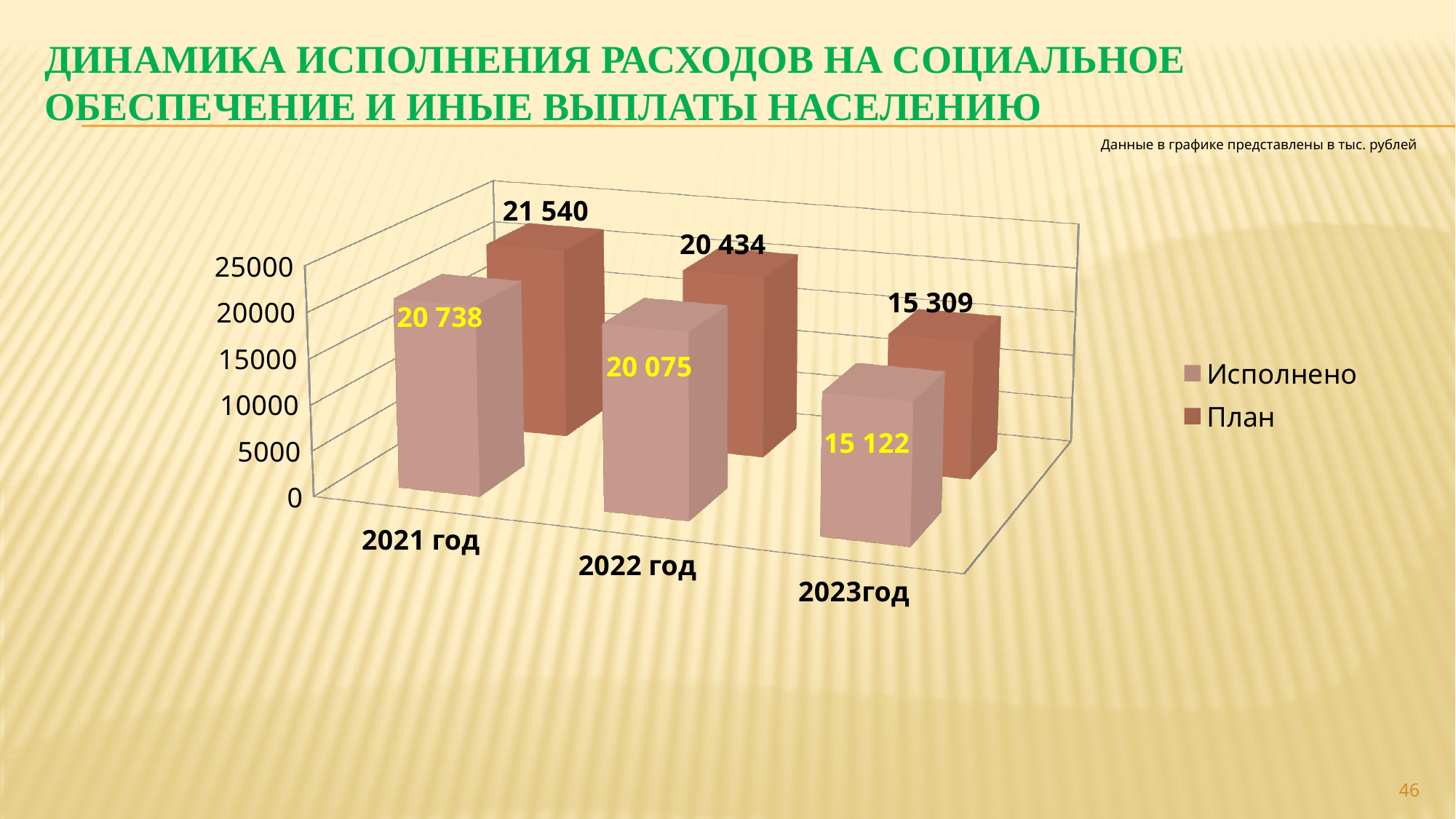
What is the difference between План and Исполнено for 2021 год? 802 What is the difference between План and Исполнено for 2022 год? 359 What is the value of План for 2022 год? 20 434 Which year has the lowest Исполнено value? 2023год Which is larger for 2023год, План or Исполнено? План What is the value of Исполнено for 2023год? 15 122 How many series does the legend list? 2 What is the value of Исполнено for 2021 год? 20 738 What is the value of План for 2023год? 15 309 Do the Исполнено values rise or fall from 2021 год to 2023год? fall Which year has the highest План value? 2021 год How many years are shown on the x axis? 3